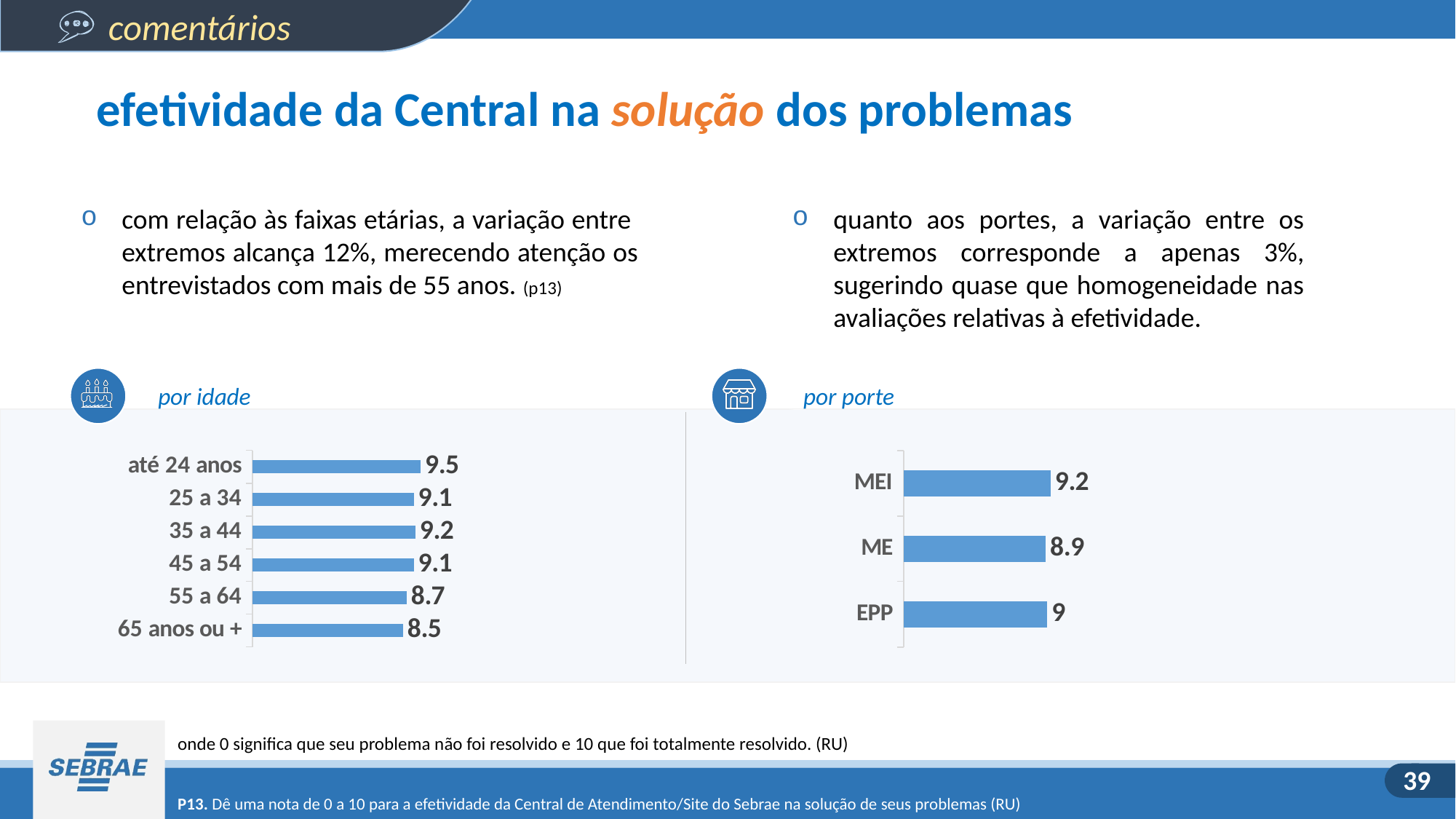
In the 'por idade' chart, what is the value for '55 a 64'? 8.7 In the 'por idade' chart, which age group has the lowest value? 65 anos ou + In the 'por porte' chart, which category has the highest value? MEI In the 'por porte' chart, what is the difference between the values for MEI and ME? 0.3 In the 'por idade' chart, which is larger, the value for '35 a 44' or the value for '55 a 64'? 35 a 44 In the 'por idade' chart, how many age groups are shown? 6 In the 'por idade' chart, what is the difference between the values for 'até 24 anos' and '65 anos ou +'? 1 What type of chart is the 'por porte' chart? bar chart In the 'por porte' chart, what is the value for ME? 8.9 In the 'por idade' chart, which age group has the highest value? até 24 anos In the 'por idade' chart, what is the value for 'até 24 anos'? 9.5 In the 'por porte' chart, what is the value for EPP? 9